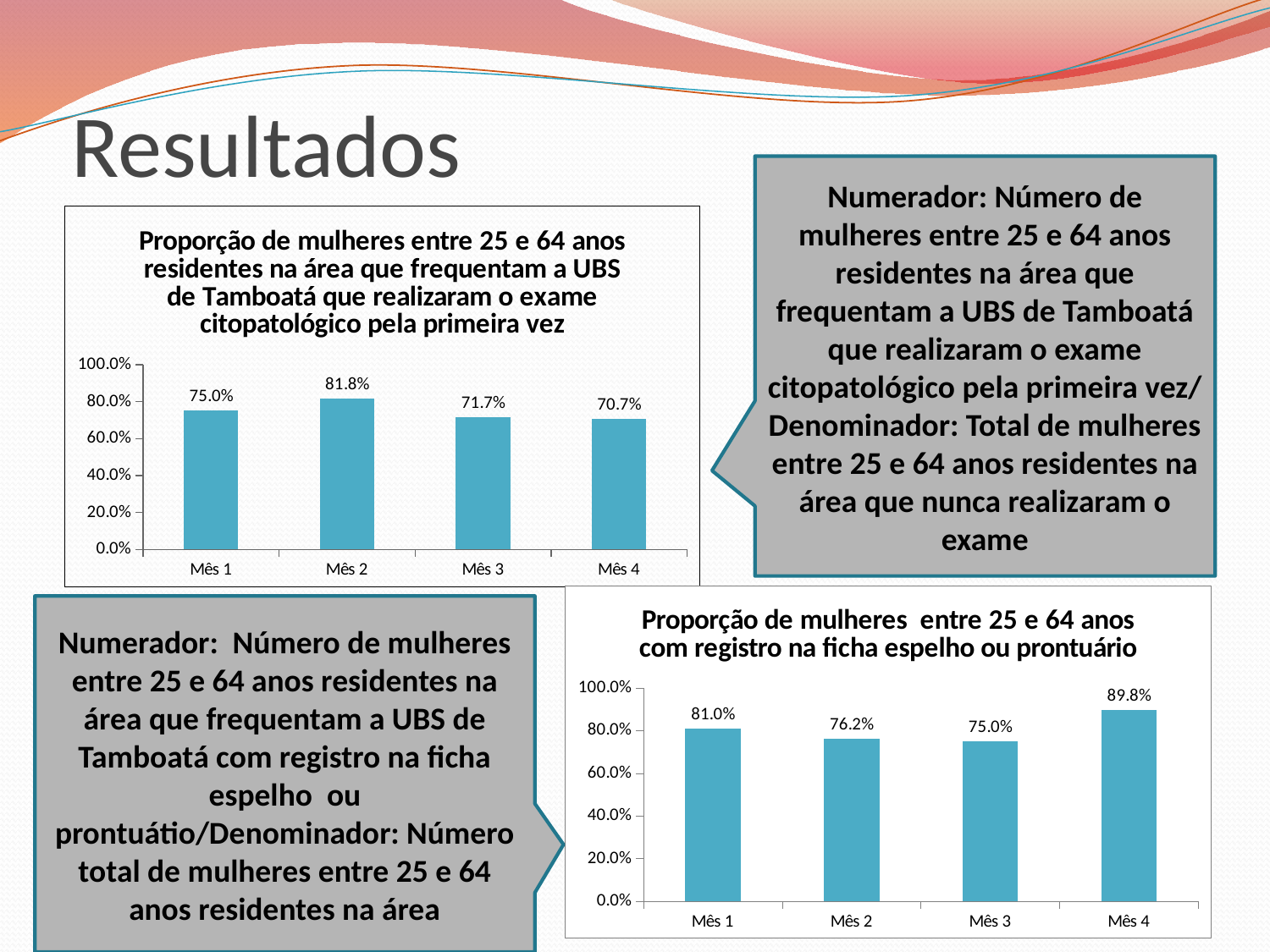
In the bottom-right chart, what is the difference between the values for Mês 4 and Mês 1? 8.8% In the top-left chart, how many months are plotted? 4 In the top-left chart, is the value for Mês 3 greater or less than 80.0%? less In the top-left chart, what is the difference between the values for Mês 2 and Mês 4? 11.1% In the bottom-right chart, which month has the lowest value? Mês 3 What kind of chart is the bottom-right chart? bar chart In the bottom-right chart, which month has the highest value? Mês 4 In the top-left chart, which month has the lowest value? Mês 4 In the bottom-right chart, what is the value for Mês 4? 89.8% In the top-left chart, what is the value for Mês 2? 81.8% In the bottom-right chart, which is larger, the value for Mês 1 or Mês 2? Mês 1 In the top-left chart, which month has the highest value? Mês 2